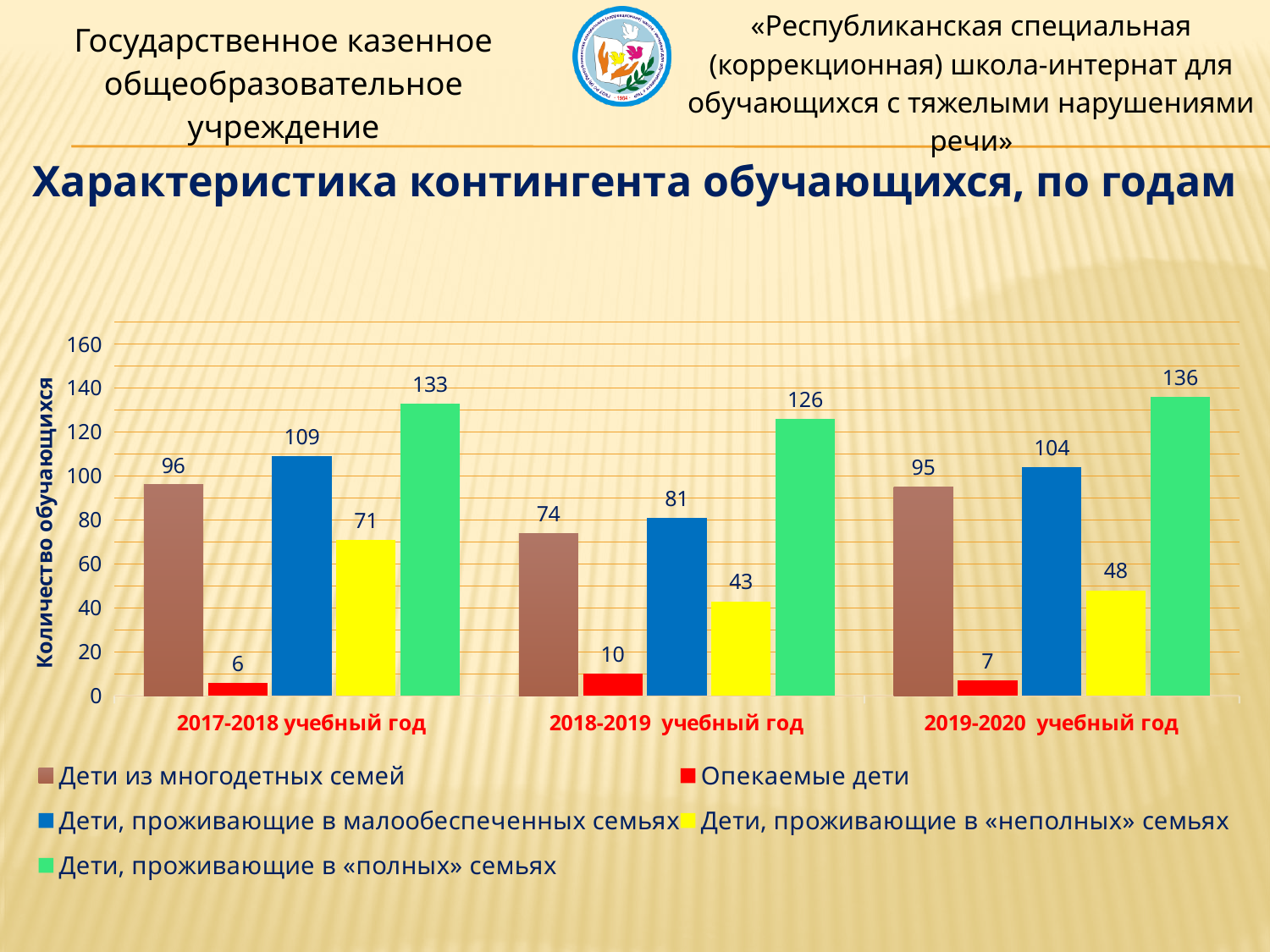
How many series does the legend list? 5 What is the value for «Дети, проживающие в «неполных» семьях» in 2019-2020 учебный год? 48 What kind of chart is shown on the slide? Bar chart How many school years are shown on the x axis? 3 In which school year is the value for «Дети, проживающие в малообеспеченных семьях» the highest? 2017-2018 учебный год Which is larger: «Дети, проживающие в «неполных» семьях» in 2017-2018 or in 2019-2020? 2017-2018 учебный год What is the label of the vertical axis? Количество обучающихся What is the value for «Дети, проживающие в «полных» семьях» in 2019-2020 учебный год? 136 What is the value for «Опекаемые дети» in 2018-2019 учебный год? 10 What is the difference between the values for «Дети, проживающие в «полных» семьях» in 2017-2018 and 2018-2019? 7 What is the value for «Дети из многодетных семей» in 2017-2018 учебный год? 96 In which school year is the value for «Дети из многодетных семей» the lowest? 2018-2019 учебный год